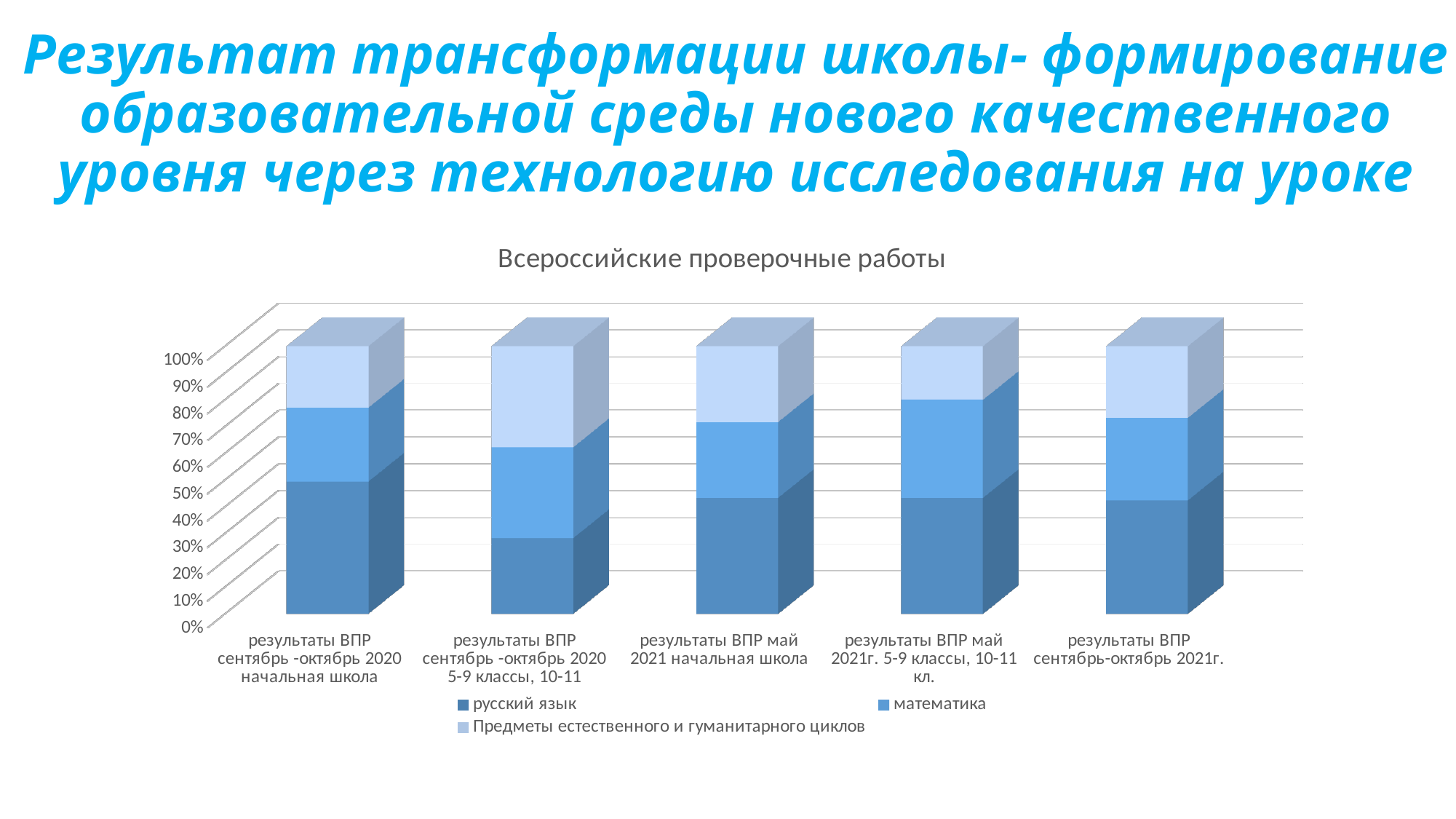
Which has the larger русский язык share: 'результаты ВПР сентябрь -октябрь 2020 начальная школа' or 'результаты ВПР сентябрь -октябрь 2020 5-9 классы, 10-11'? результаты ВПР сентябрь -октябрь 2020 начальная школа How many categories are shown on the x axis? 5 Which series is shown in the lightest blue colour? Предметы естественного и гуманитарного циклов What is the highest value shown on the y axis? 100% What is the title of the chart? Всероссийские проверочные работы What is the total height of each stacked bar on the y axis? 100% Is the русский язык share for 'результаты ВПР сентябрь -октябрь 2020 5-9 классы, 10-11' greater or less than 40%? less What kind of chart is shown on the slide? stacked bar chart Is the русский язык share for 'результаты ВПР сентябрь -октябрь 2020 начальная школа' greater or less than 40%? greater Which category has the smallest русский язык share? результаты ВПР сентябрь -октябрь 2020 5-9 классы, 10-11 Which category has the largest share for Предметы естественного и гуманитарного циклов? результаты ВПР сентябрь -октябрь 2020 5-9 классы, 10-11 How many series does the legend list? 3